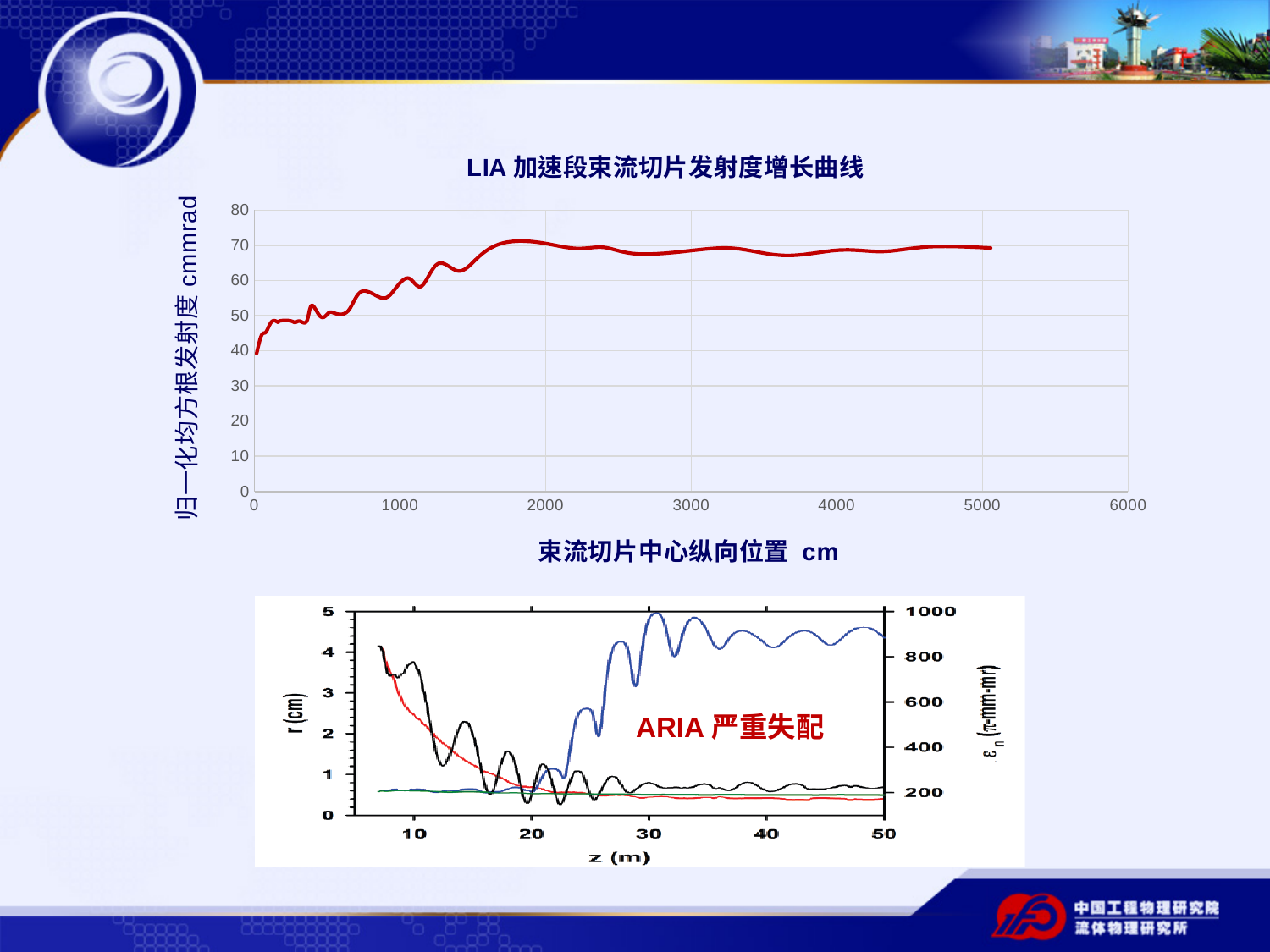
What is the x-axis label of the top chart? 束流切片中心纵向位置 cm In the top chart, is the value at position 1000 greater or less than 70? less What is the largest tick value shown on the x axis of the top chart? 6000 In the top chart, is the value at position 0 greater or less than 30? greater In the bottom chart, what is the x-axis label? z (m) In the bottom chart, is the blue curve at z = 40 greater or less than 600 on the right-hand axis? greater In the top chart, which is larger: the value at position 0 or the value at position 3000? the value at position 3000 In the top chart, does the plotted value overall rise or fall as the longitudinal position increases from 0 to 5000 cm? rise What kind of chart is the top chart titled 'LIA 加速段束流切片发射度增长曲线'? line chart